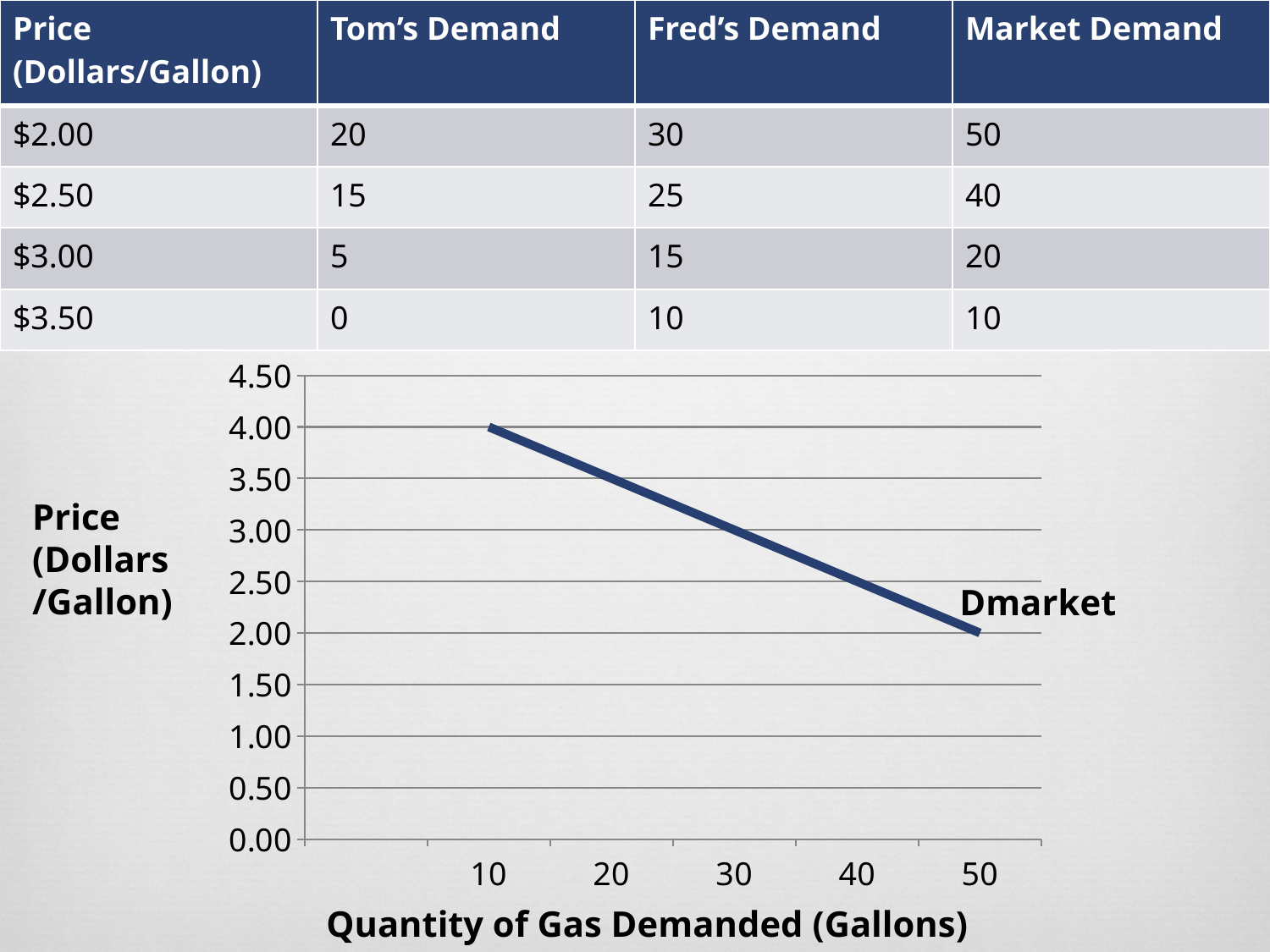
Is the price on the Dmarket line at a quantity of 40 gallons greater or less than 2.00? greater Is the price on the Dmarket line at a quantity of 20 gallons greater or less than 3.00? greater What label is attached to the line plotted on the chart? Dmarket What price does the Dmarket line show at a quantity of 50 gallons? 2.00 What is the title of the x axis of the chart? Quantity of Gas Demanded (Gallons) Which quantity has the higher price on the Dmarket line, 10 gallons or 50 gallons? 10 gallons Is the price on the Dmarket line at a quantity of 30 gallons greater or less than 3.50? less What kind of chart is shown on the slide? line chart What is the difference between the price at 10 gallons and the price at 50 gallons on the Dmarket line? 2.00 What price does the Dmarket line show at a quantity of 10 gallons? 4.00 Does the Dmarket line rise or fall as quantity increases along the x axis? fall How many labeled quantity ticks are shown on the x axis of the chart? 5